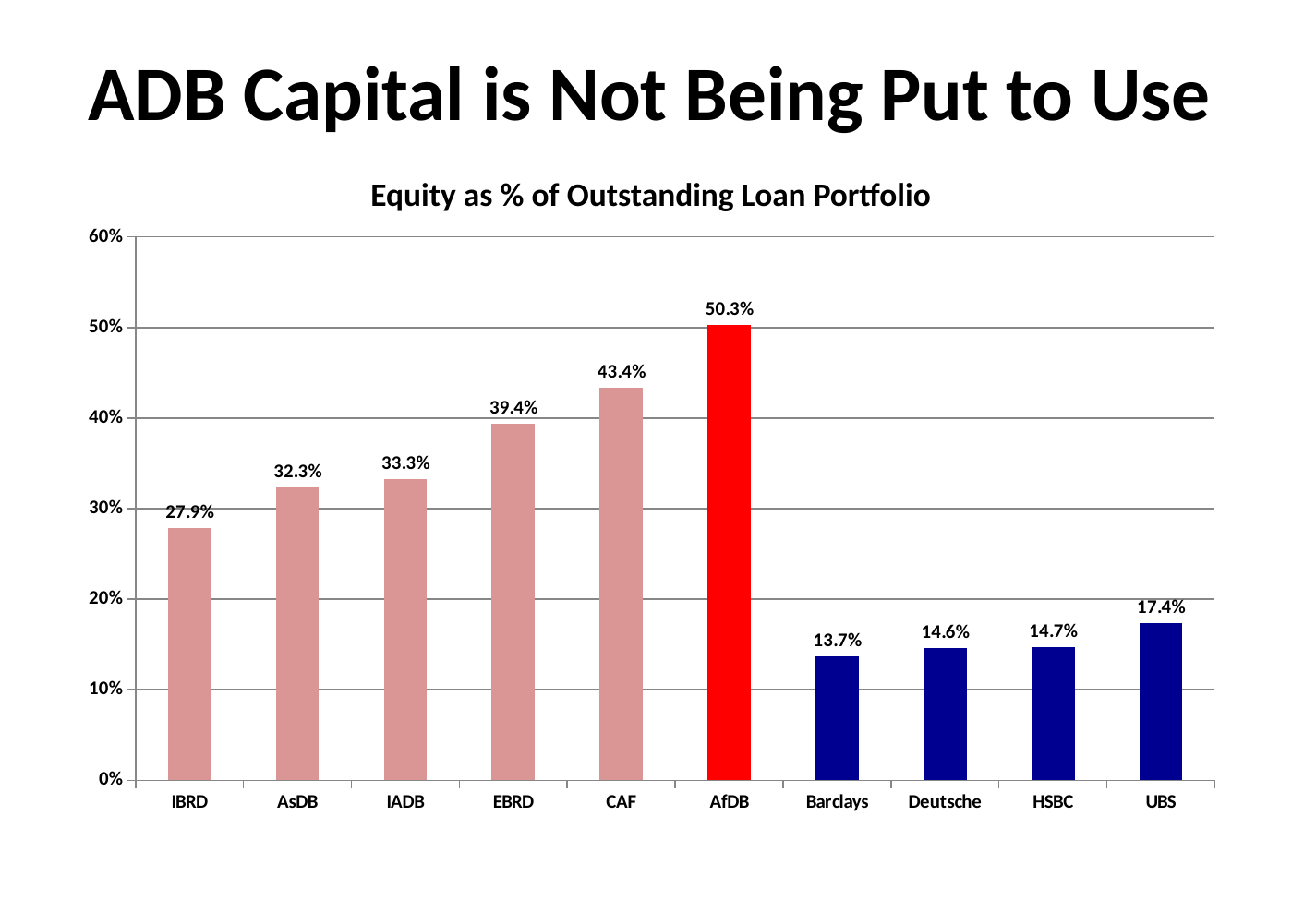
What kind of chart is shown on the slide? bar chart Which category has the highest value? AfDB What is the value for Barclays? 13.7% What is the title of the chart? Equity as % of Outstanding Loan Portfolio Is the value for CAF greater or less than 40%? greater What is the value for AfDB? 50.3% Which category has the lowest value? Barclays Which is larger, the value for IBRD or the value for UBS? IBRD What is the difference between the values for AfDB and CAF? 6.9% What is the value for EBRD? 39.4% Which bar is coloured red? AfDB How many categories are shown on the x axis? 10